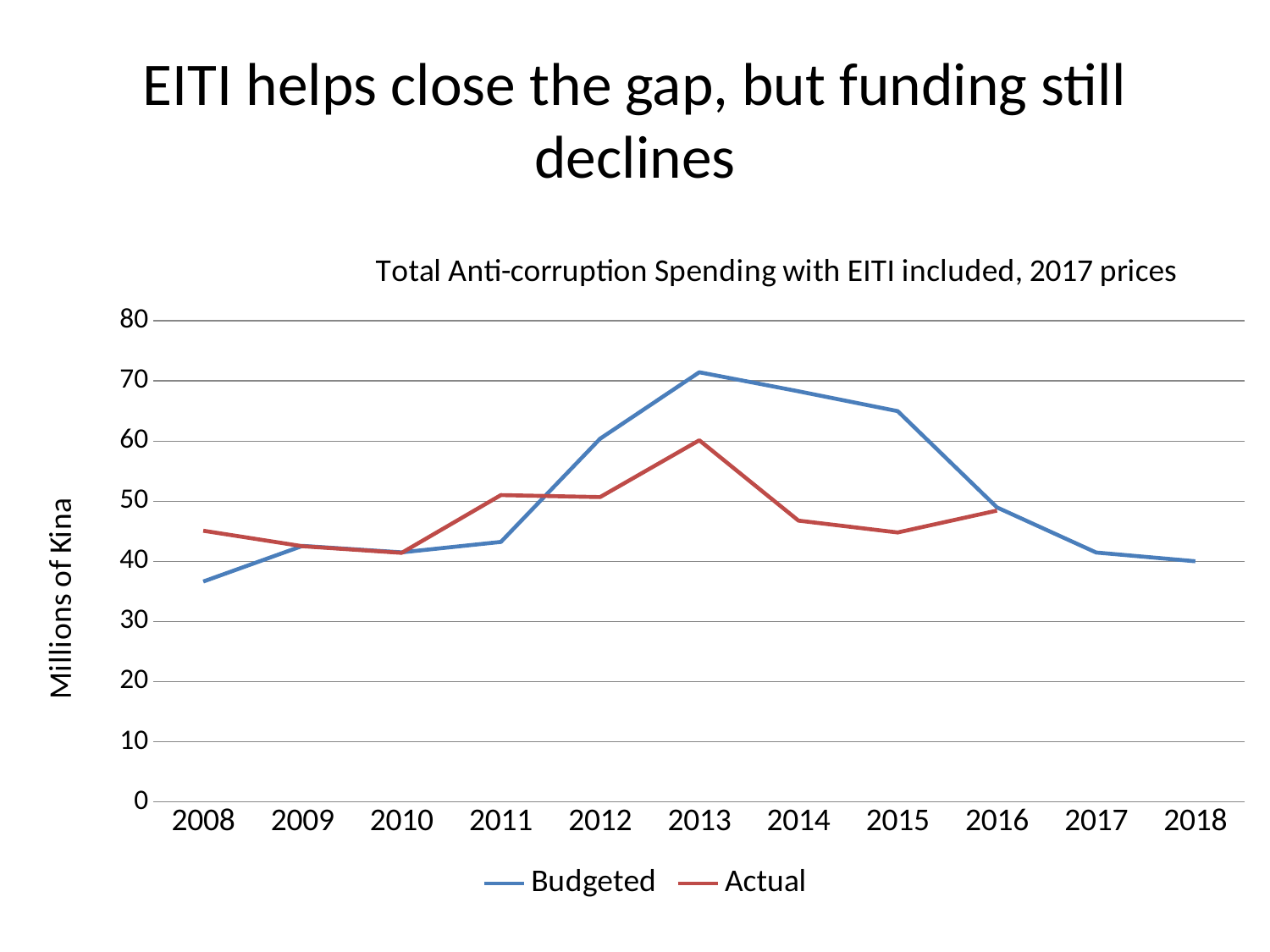
In which year does the Budgeted series reach its highest value? 2013 In which year does the Actual series reach its highest value? 2013 Is the Actual value for 2014 greater or less than 50? less What kind of chart is shown on the slide? line chart What is the label on the vertical axis? Millions of Kina Does the Budgeted series rise or fall from 2013 to 2018? fall How many series does the legend list? 2 Is the Budgeted value for 2008 greater or less than 40? less In which year is the Budgeted series at its lowest value? 2008 How many years are shown on the x axis? 11 Which series has the higher value in 2015, Budgeted or Actual? Budgeted Is the Budgeted value for 2013 greater or less than 70? greater